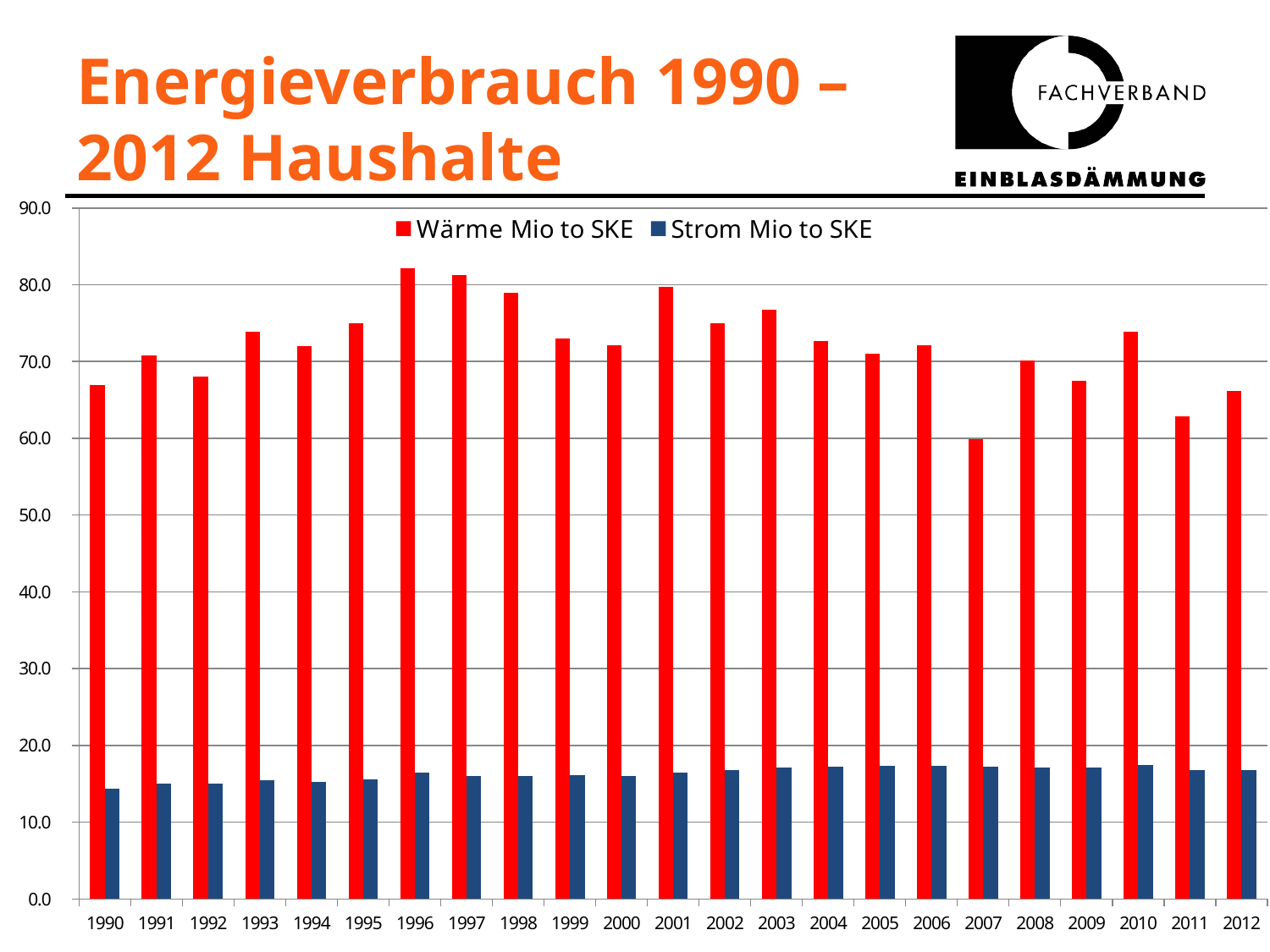
In which year is the Wärme Mio to SKE value lowest? 2007 What kind of chart is shown on the slide? bar chart How many series does the legend list? 2 Is the Wärme Mio to SKE value for 2011 greater or less than 60.0? greater Is the Wärme Mio to SKE value for 1996 greater or less than 80.0? greater Which colour represents the Wärme Mio to SKE series? red Which is larger, the Wärme Mio to SKE value for 1990 or for 1991? 1991 Does the Wärme Mio to SKE value rise or fall from 2003 to 2007? fall Is the Strom Mio to SKE value for 2005 greater or less than 20.0? less How many years are shown along the x axis? 23 Which is larger, the Wärme Mio to SKE value for 1996 or for 2007? 1996